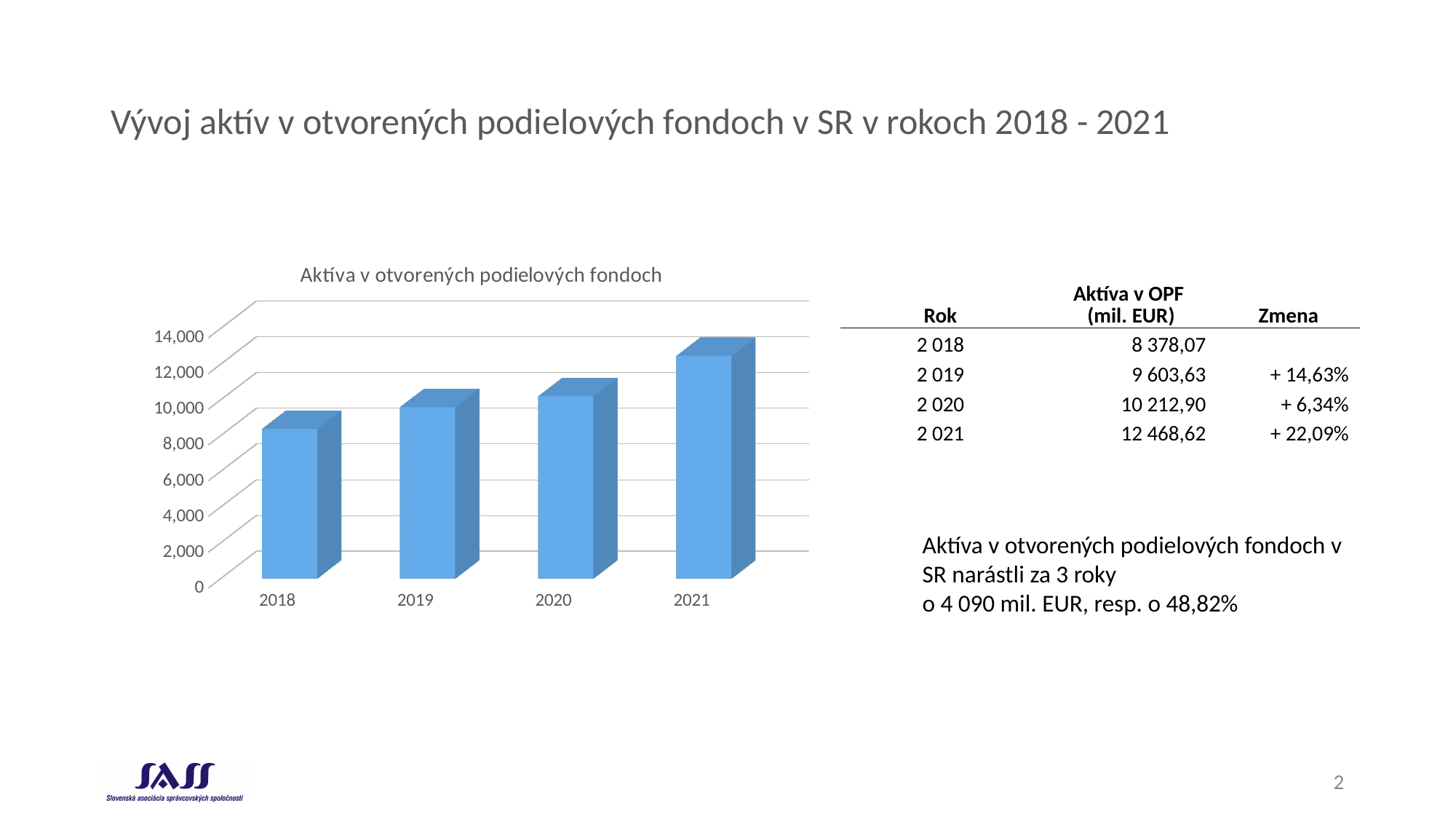
How many years (categories) are plotted in the chart? 4 Is the bar for 2021 greater or less than 10,000? greater Which is larger, the value for 2020 or the value for 2018? 2020 What type of chart is shown on the slide? bar chart Which year has the highest bar in the chart? 2021 Do the values in the chart rise or fall from 2018 to 2021? rise Is the bar for 2019 greater or less than 8,000? greater Which year has the lowest bar in the chart? 2018 According to the table on the slide, what were the assets in open-end mutual funds (mil. EUR) in 2021? 12 468,62 What is the title of the chart? Aktíva v otvorených podielových fondoch According to the table on the slide, what was the percentage change (Zmena) in 2019? + 14,63% Is the bar for 2018 greater or less than 10,000? less